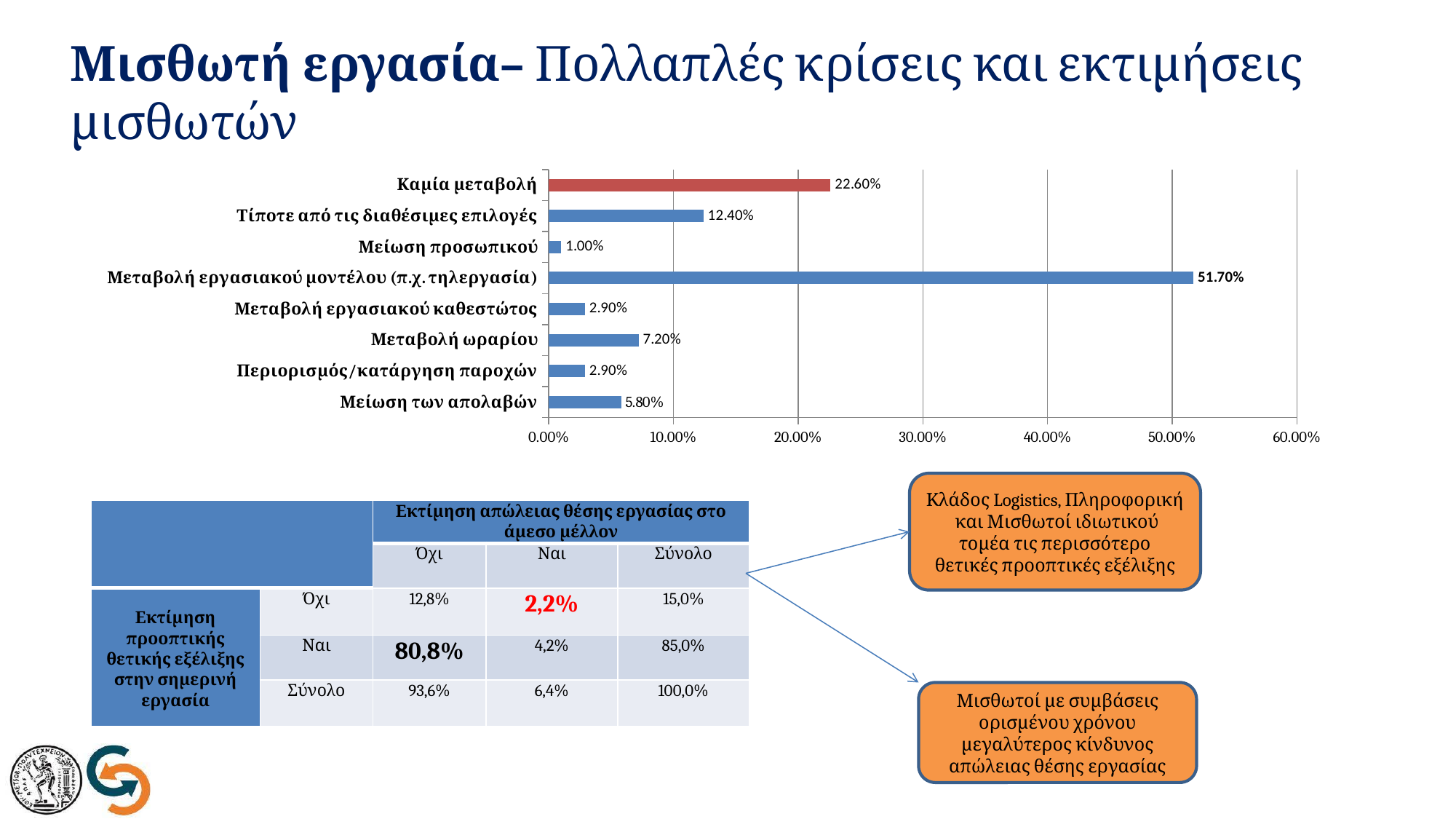
Which category has the lowest value in the bar chart? Μείωση προσωπικού Is the value for Μεταβολή εργασιακού μοντέλου (π.χ. τηλεργασία) greater or less than 50.00%? greater What value does the bar chart show for Μείωση των απολαβών? 5.80% What value does the bar chart show for Καμία μεταβολή? 22.60% How many categories are shown in the bar chart? 8 What kind of chart is shown on the slide? bar chart What is the difference between the values for Καμία μεταβολή and Τίποτε από τις διαθέσιμες επιλογές? 10.20% Which bar in the chart is coloured red rather than blue? Καμία μεταβολή What value does the bar chart show for Μεταβολή ωραρίου? 7.20% Which is larger in the bar chart: Μεταβολή ωραρίου or Μείωση των απολαβών? Μεταβολή ωραρίου Which category has the highest value in the bar chart? Μεταβολή εργασιακού μοντέλου (π.χ. τηλεργασία) What value does the bar chart show for Μεταβολή εργασιακού μοντέλου (π.χ. τηλεργασία)? 51.70%